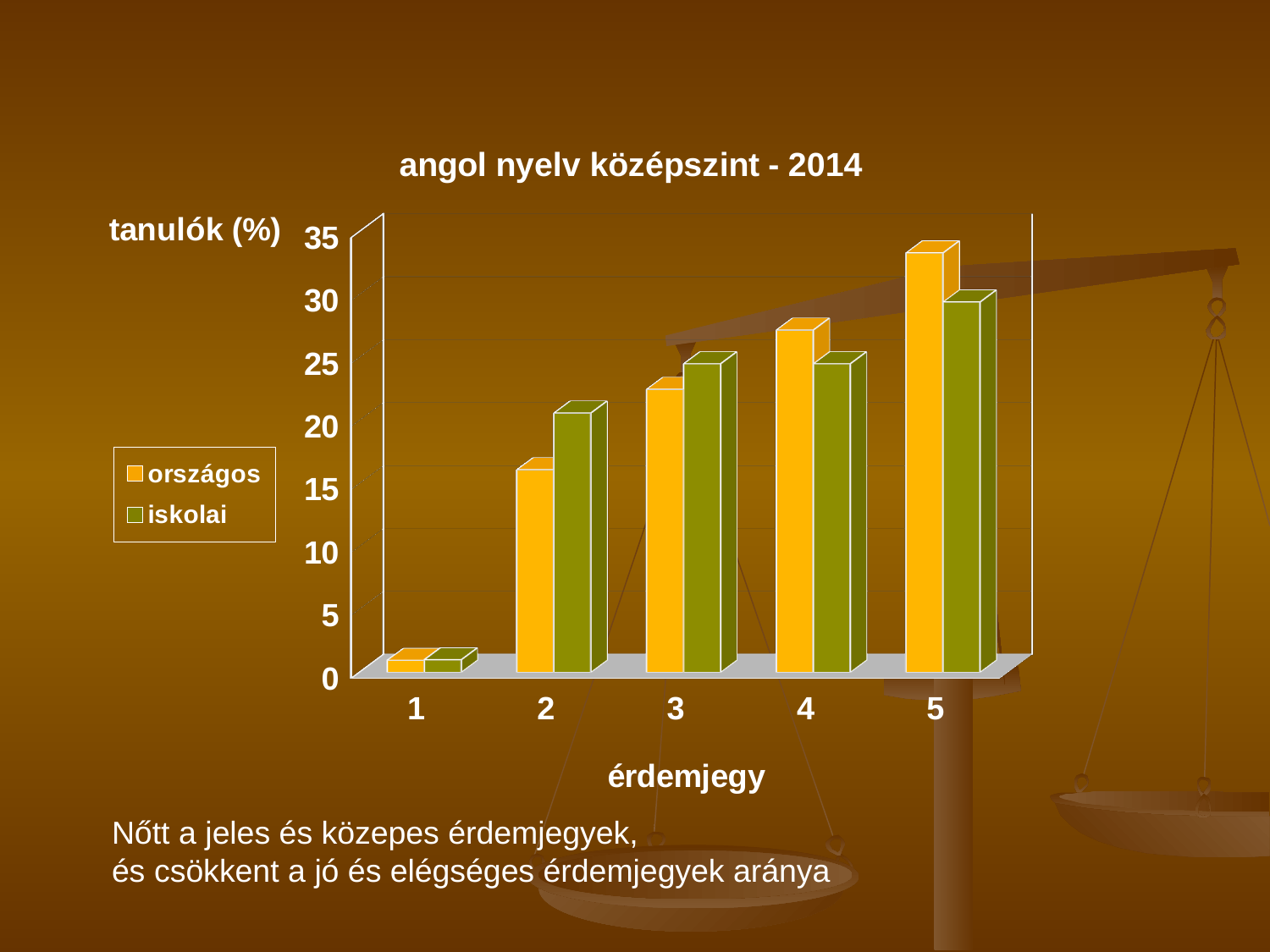
For grade 5, which series has the larger value, országos or iskolai? országos What is the title of the chart? angol nyelv középszint - 2014 Do the országos values rise or fall as the grade increases from 1 to 5? rise How many series does the legend list? 2 For grade 2, which series has the larger value, országos or iskolai? iskolai What kind of chart is shown on the slide? bar chart How many grade categories (érdemjegy) are shown on the x axis? 5 Is the országos value for grade 2 greater or less than 20? less For which grade is the iskolai value lowest? 1 Is the országos value for grade 5 greater or less than 30? greater For which grade is the országos value highest? 5 What are the two series named in the legend? országos, iskolai